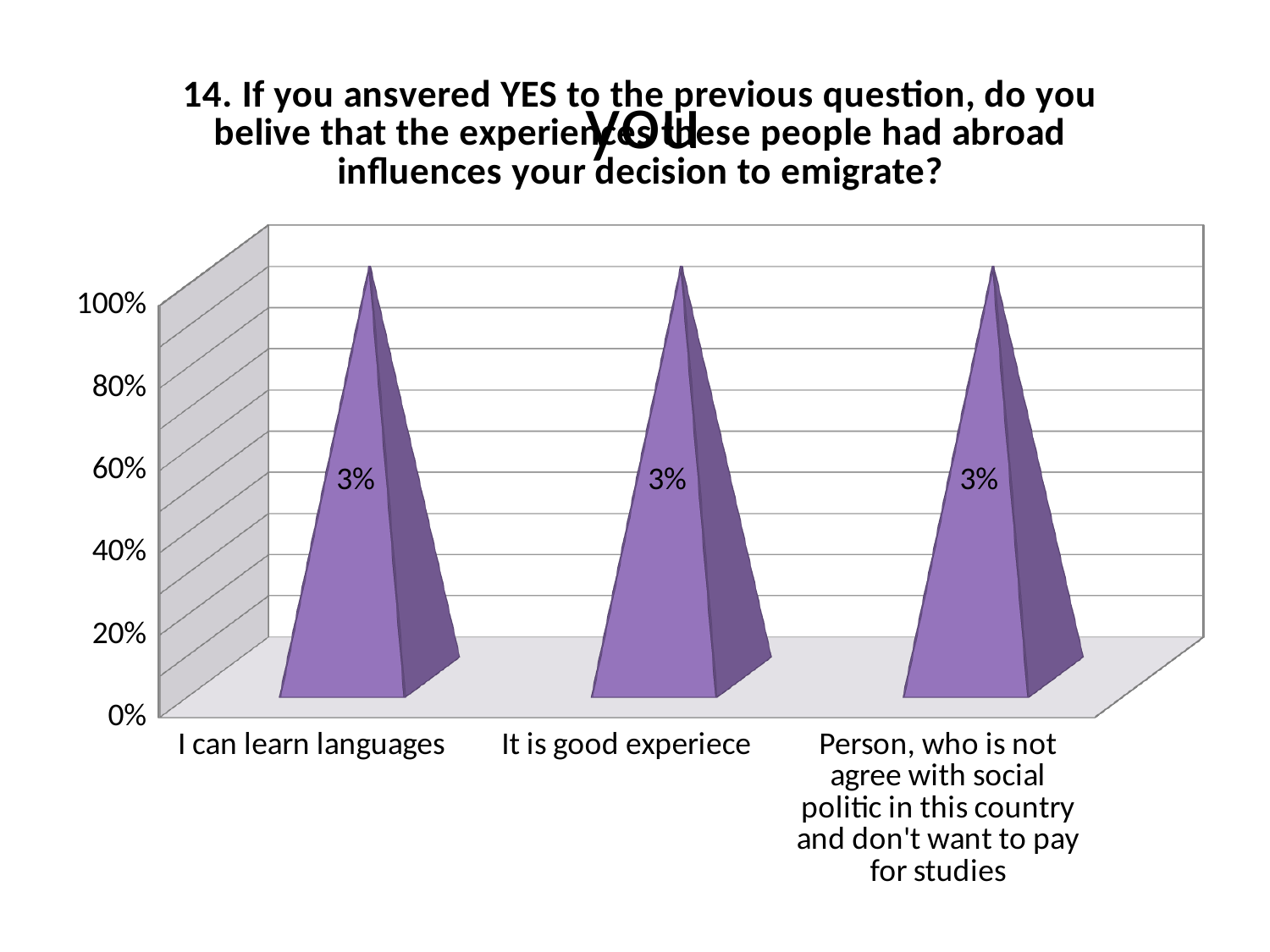
What is the data label shown for "It is good experiece"? 3% Do the data labels for "I can learn languages" and "It is good experiece" show the same value? Yes, both 3% What kind of chart is shown on the slide? bar chart What is the data label shown for "I can learn languages"? 3% What colour are the bars in the chart? Purple What is the label of the first category on the x axis? I can learn languages What is the data label shown for "Person, who is not agree with social politic in this country and don't want to pay for studies"? 3% What is the highest tick value shown on the vertical axis? 100% How many categories are plotted on the chart? 3